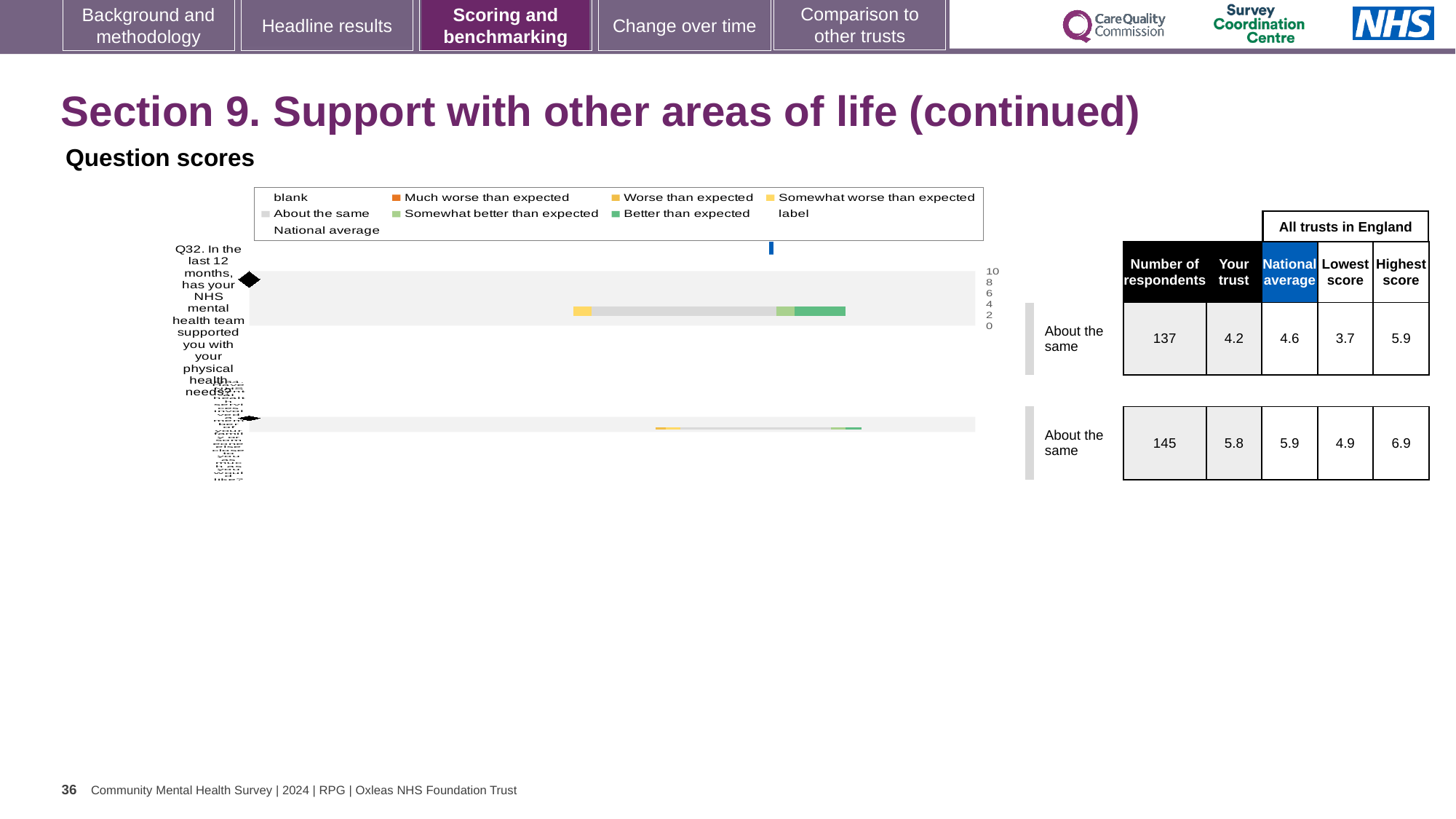
For Q32, which is larger: the trust's score or the national average? national average What is the highest score among all trusts in England for Q32? 5.9 What is the difference between the highest and lowest trust scores for Q32? 2.2 How many entries does the chart legend list? 9 How many question bars are plotted in the chart? 2 What is the difference between the national average and the trust's score for Q32? 0.4 What colour represents 'Better than expected' in the chart legend? green What is the 'Your trust' score for the second (lower) question bar in the chart? 5.8 How many respondents answered Q32? 137 What is the 'Your trust' score for Q32 (support with physical health needs)? 4.2 What is the national average score for Q32? 4.6 What kind of chart is shown on the slide? bar chart